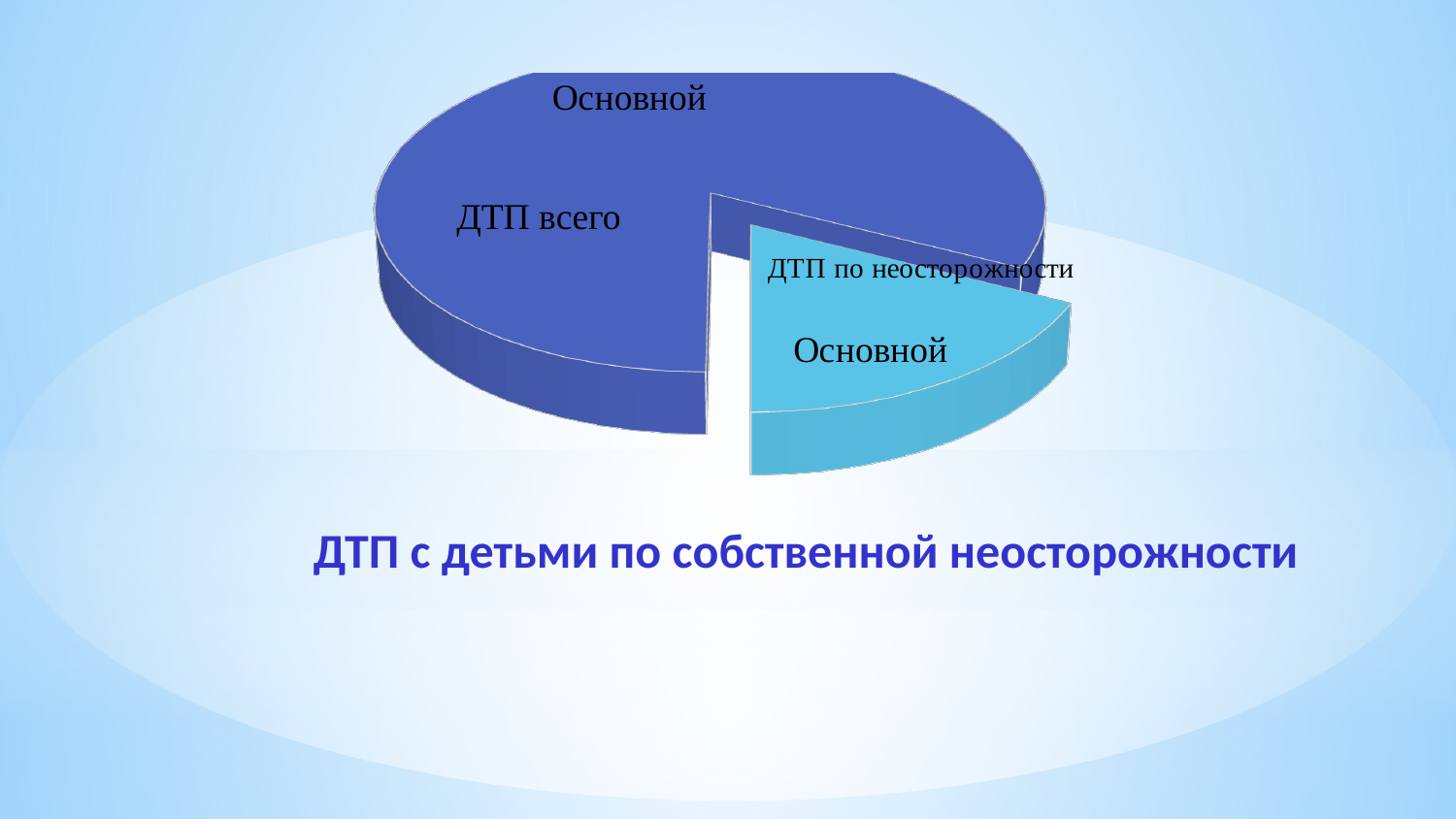
What kind of chart is shown on the slide? pie chart What is the title text shown below the pie chart? ДТП с детьми по собственной неосторожности Which slice of the pie chart is the largest? ДТП всего Which slice is larger: ДТП всего or ДТП по неосторожности? ДТП всего How many slices does the pie chart have? 2 Which slice of the pie chart is pulled out (exploded) from the rest of the pie? ДТП по неосторожности Which slice of the pie chart is the smallest? ДТП по неосторожности